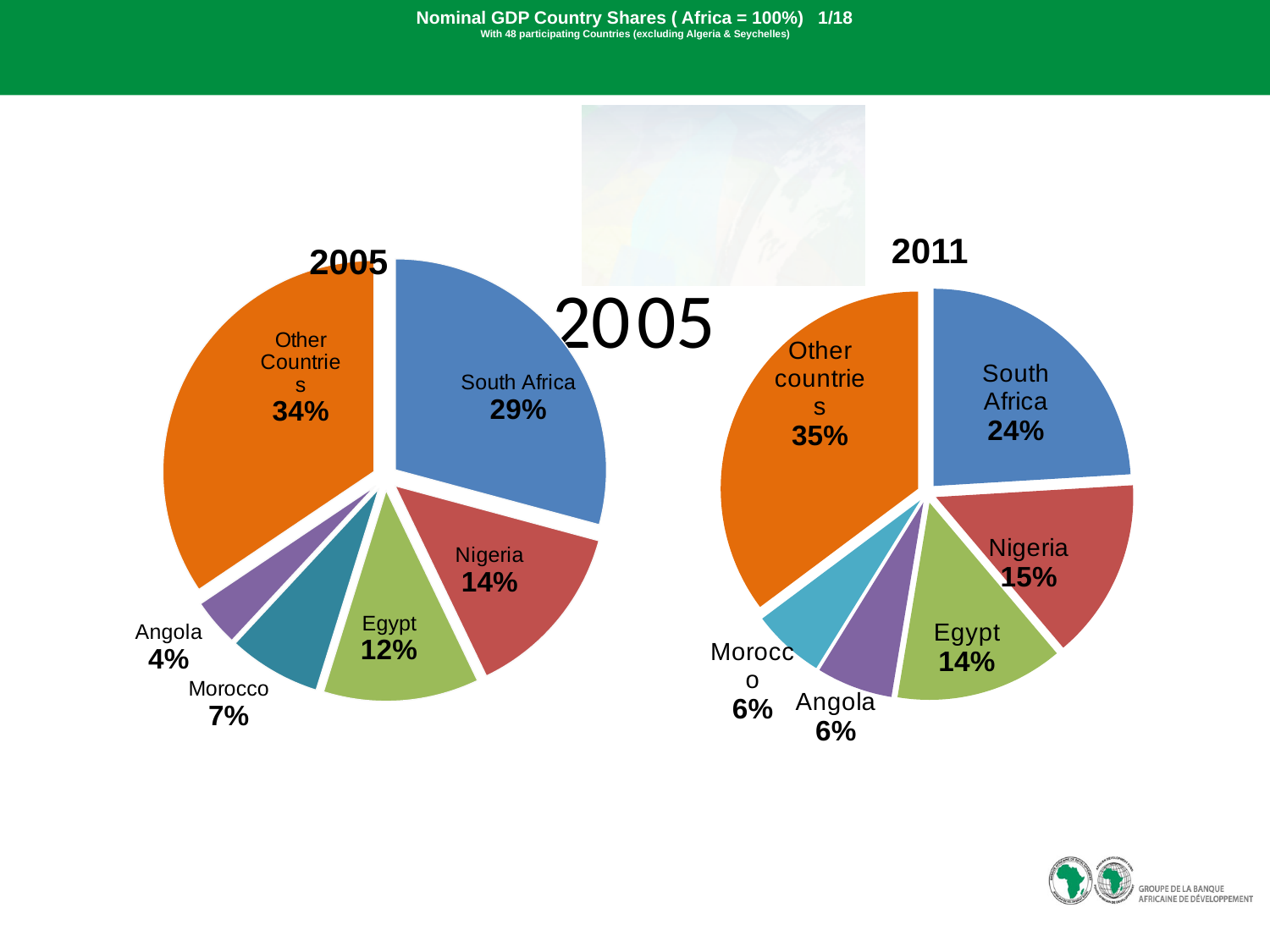
How many slices does the 2011 pie chart have? 6 What is the title of the slide containing the two pie charts? Nominal GDP Country Shares ( Africa = 100%) In the 2011 pie chart, which slice is the largest? Other countries In the 2005 pie chart, what share does Angola have? 4% What kind of chart is used to show the 2005 country shares? Pie chart In the 2011 pie chart, what share does Nigeria have? 15% In the 2005 pie chart, what is the difference between the shares of South Africa and Nigeria? 15% In the 2011 pie chart, what share does Morocco have? 6% In the 2011 pie chart, which is larger, the share of Egypt or the share of South Africa? South Africa In the 2005 pie chart, which slice is the smallest? Angola In the 2005 pie chart, what share does South Africa have? 29% In the 2005 pie chart, what is the combined share of Egypt and Morocco? 19%